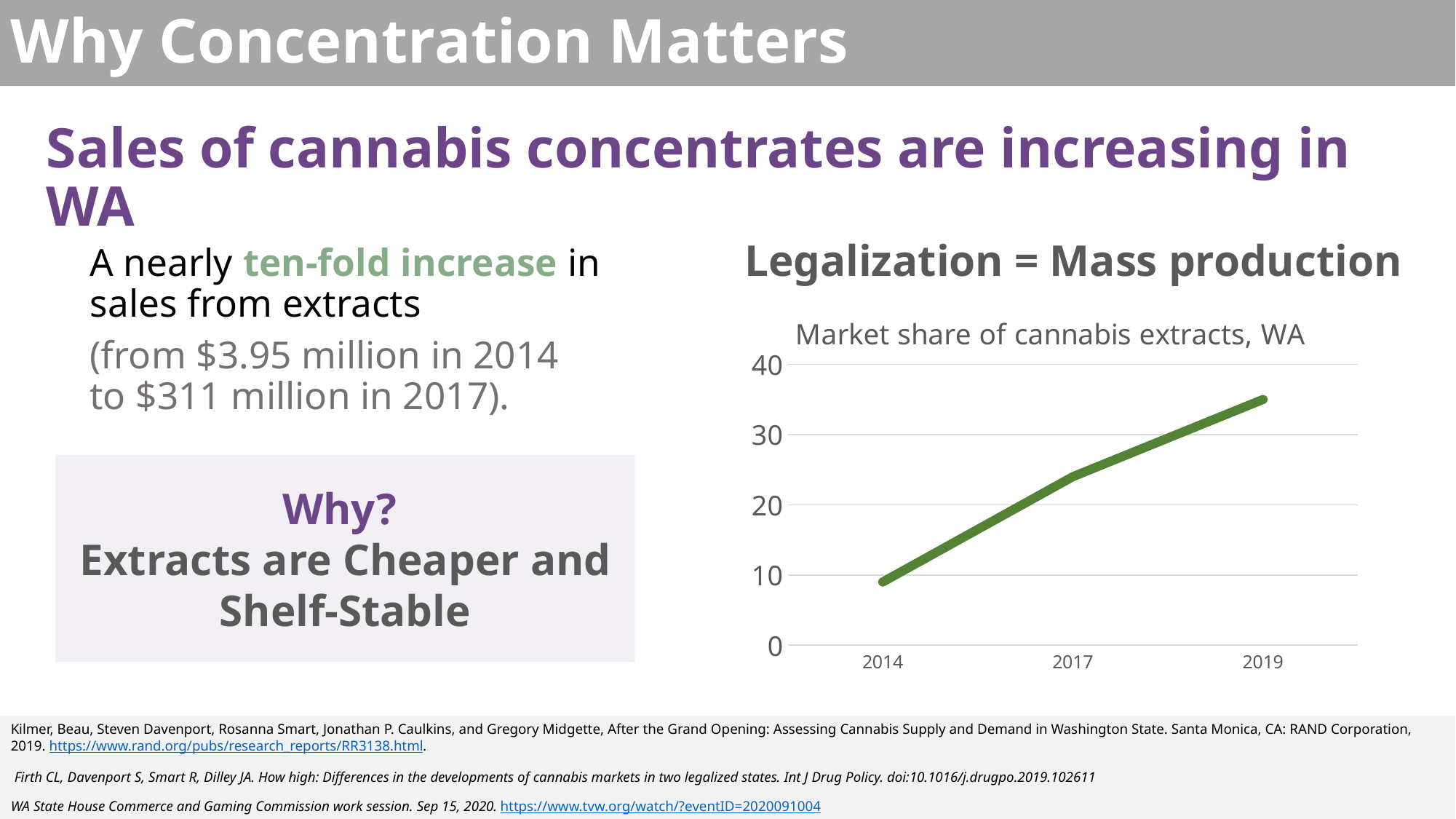
Which year has the lowest market share of cannabis extracts? 2014 Is the market share of cannabis extracts in 2019 greater or less than 30? greater Which is larger, the market share of cannabis extracts in 2017 or in 2019? 2019 Does the market share of cannabis extracts rise or fall from 2014 to 2019? rise What is the highest value shown on the y axis of the chart? 40 Is the market share of cannabis extracts in 2017 greater or less than 20? greater How many years are labelled on the x axis of the chart? 3 What is the title of the chart? Market share of cannabis extracts, WA Is the market share of cannabis extracts in 2014 greater or less than 20? less Which year has the highest market share of cannabis extracts? 2019 What kind of chart is shown on the slide? line chart